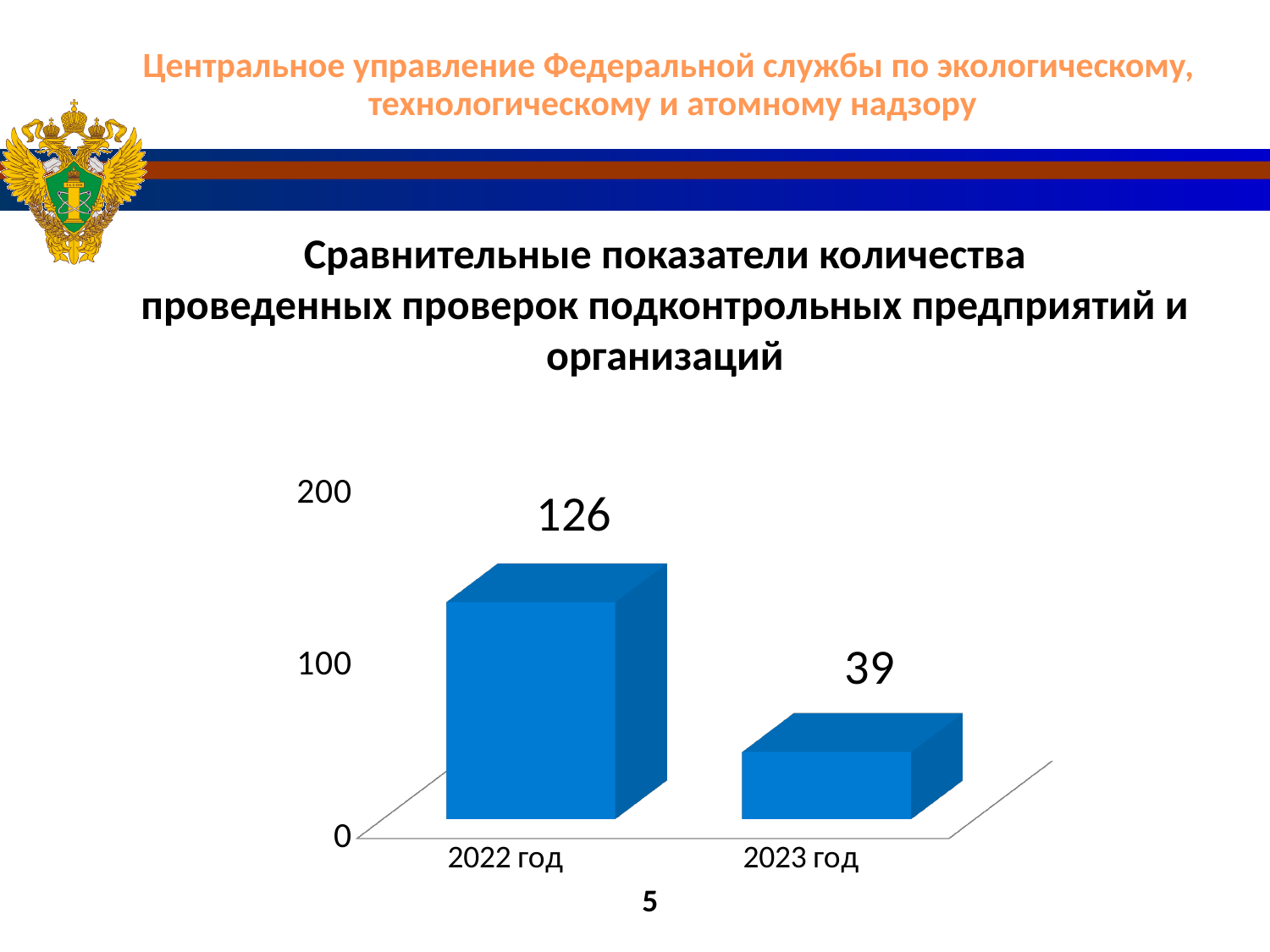
Is the value for 2023 год greater or less than 100? less Is the value for 2022 год greater or less than 100? greater Which is larger, the value for 2022 год or the value for 2023 год? 2022 год What is the highest tick value shown on the vertical axis? 200 Which year has the lowest value? 2023 год What is the value for 2023 год? 39 Which year has the highest value? 2022 год How many categories are shown on the x axis? 2 Do the values rise or fall from 2022 год to 2023 год? fall What kind of chart is shown on the slide? bar chart What is the value for 2022 год? 126 What is the difference between the values for 2022 год and 2023 год? 87